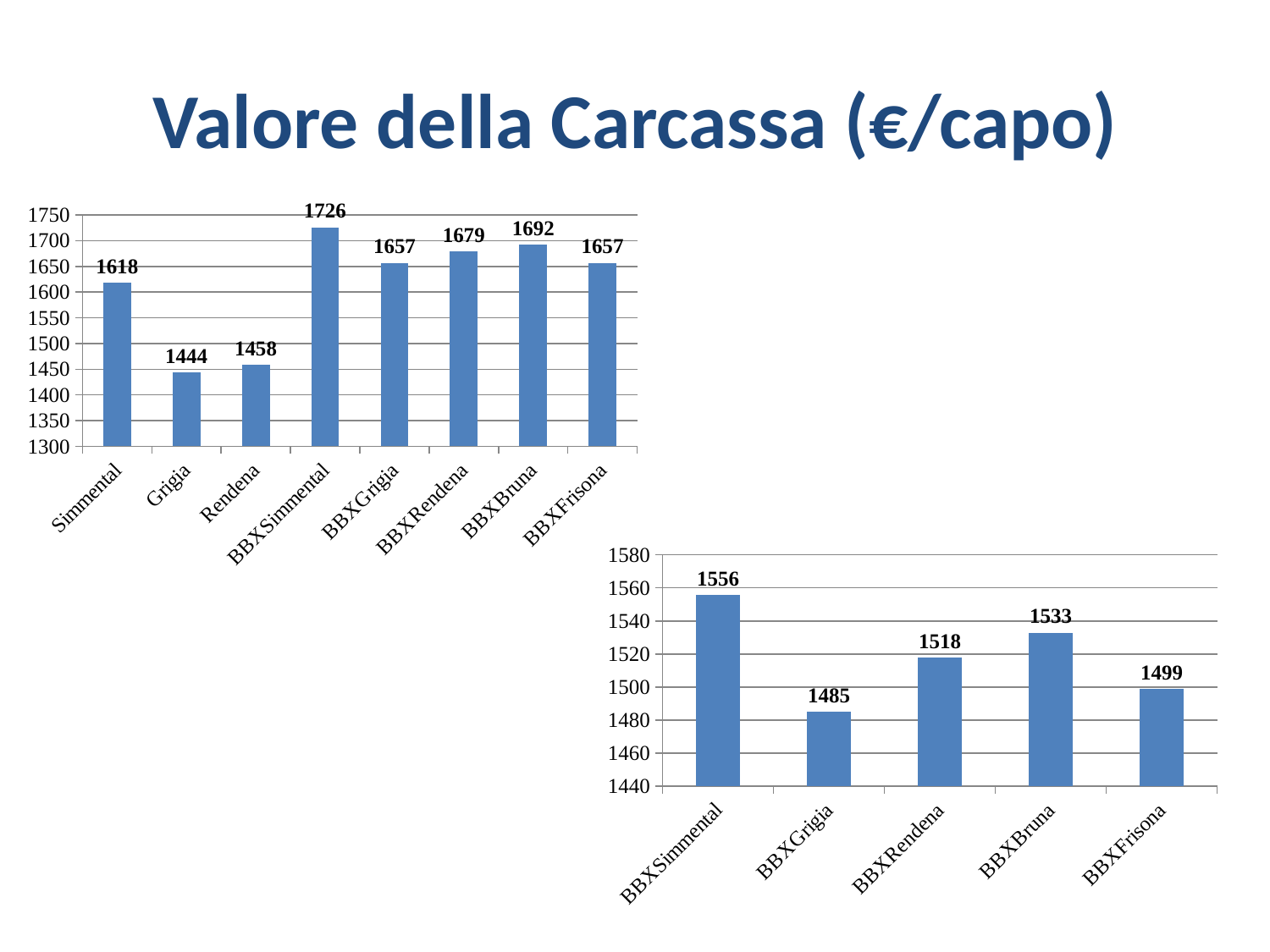
In the top-left chart, which category has the highest value? BBXSimmental In the top-left chart, which category has the lowest value? Grigia In the bottom-right chart, what is the value for BBXGrigia? 1485 In the bottom-right chart, what is the difference between the values for BBXBruna and BBXRendena? 15 In the top-left chart, what is the difference between the values for BBXSimmental and Grigia? 282 In the bottom-right chart, which category has the lowest value? BBXGrigia In the bottom-right chart, how many categories are shown? 5 In the top-left chart, how many categories are shown? 8 In the bottom-right chart, which category has the highest value? BBXSimmental What type of chart is the bottom-right chart? Bar chart In the top-left chart, which is larger, the value for Simmental or the value for BBXBruna? BBXBruna In the top-left chart, what is the value for BBXSimmental? 1726